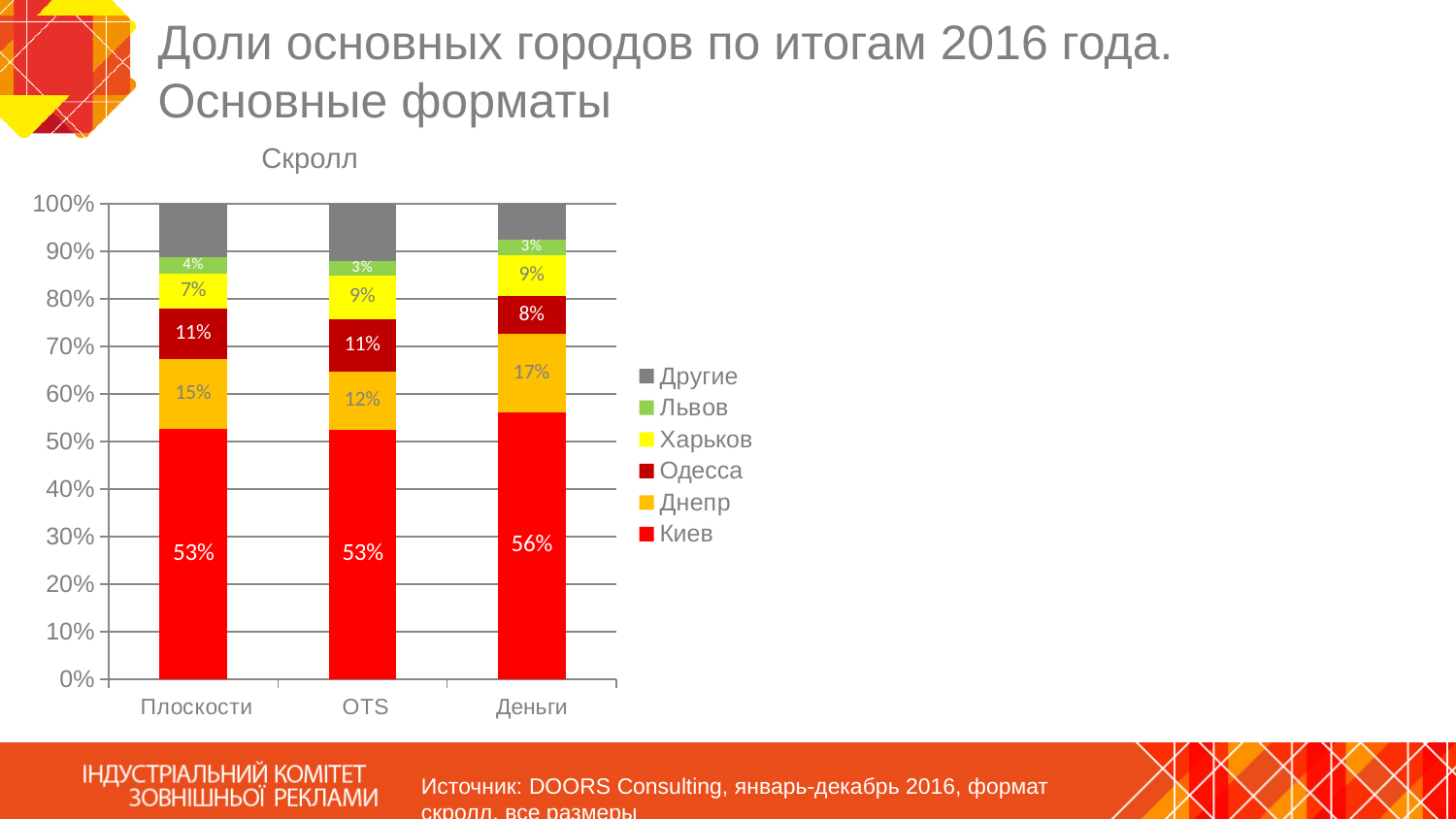
In which category does Киев have the highest share? Деньги Is the top of the Киев segment in the OTS category greater or less than 50%? greater How many categories are shown on the x axis? 3 What is the value for Львов in the Плоскости category? 4% What is the value for Киев in the Плоскости category? 53% What is the value for Харьков in the OTS category? 9% What kind of chart is shown on the slide? Stacked bar chart What is the value for Днепр in the Деньги category? 17% What is the difference between the Днепр share in Деньги and the Днепр share in OTS? 5% In which category does Одесса have the lowest share? Деньги Which is larger: the Харьков share in Плоскости or the Харьков share in Деньги? Деньги How many series does the legend list? 6